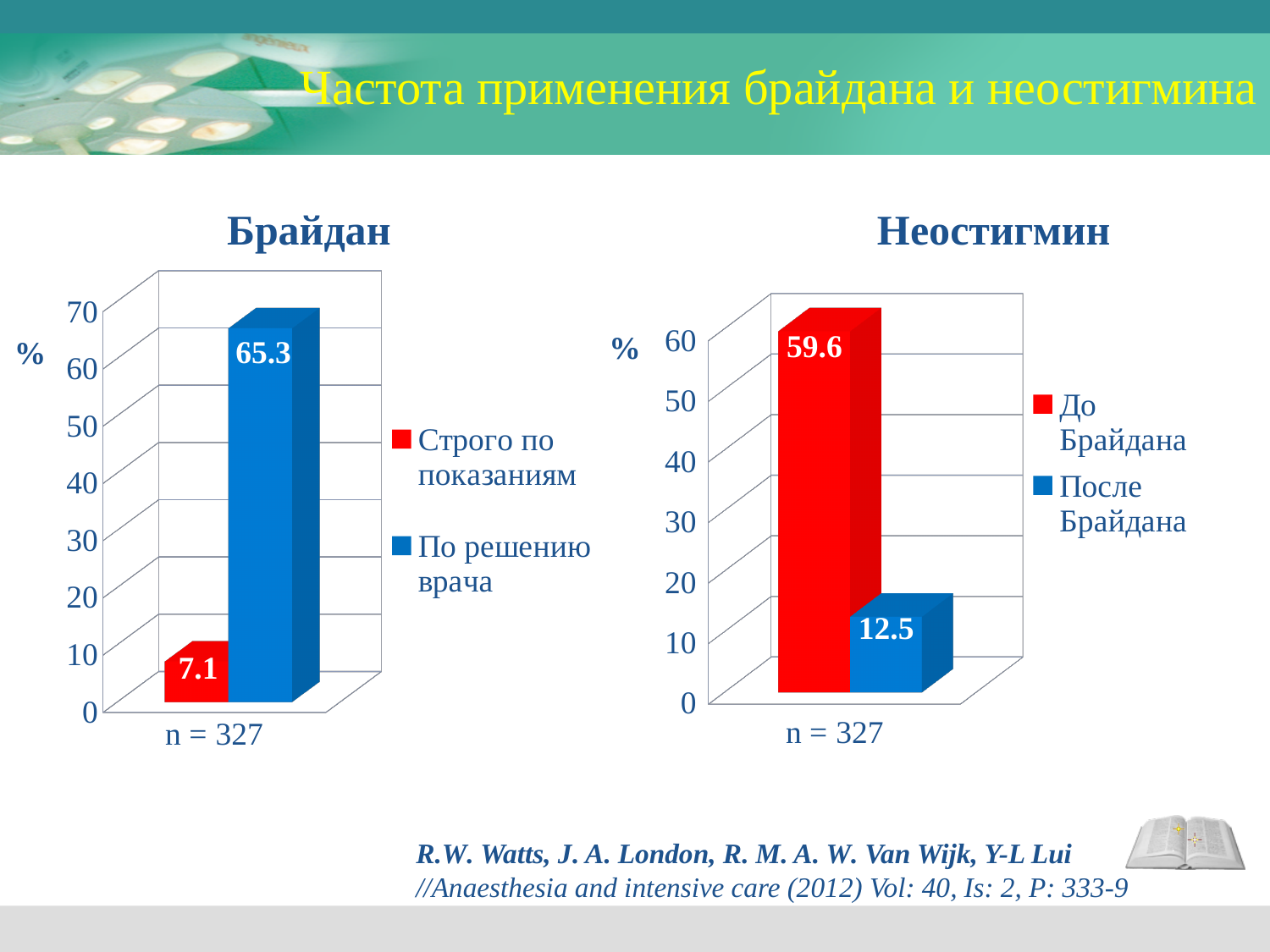
In the "Неостигмин" chart, which series has the lower value? После Брайдана In the "Неостигмин" chart, what is the difference between "До Брайдана" and "После Брайдана"? 47.1 In the "Брайдан" chart, which series has the higher value? По решению врача In the "Брайдан" chart, what is the value for "Строго по показаниям"? 7.1 In the "Брайдан" chart, what is the difference between "По решению врача" and "Строго по показаниям"? 58.2 How many series does the legend of the "Неостигмин" chart list? 2 In the "Брайдан" chart, what is the value for "По решению врача"? 65.3 What kind of chart is the "Брайдан" chart? Bar chart Is the value for "До Брайдана" in the "Неостигмин" chart larger than the value for "По решению врача" in the "Брайдан" chart? No In the "Неостигмин" chart, what is the value for "После Брайдана"? 12.5 What sample size (n) is shown under the "Брайдан" chart? n = 327 In the "Неостигмин" chart, what is the value for "До Брайдана"? 59.6